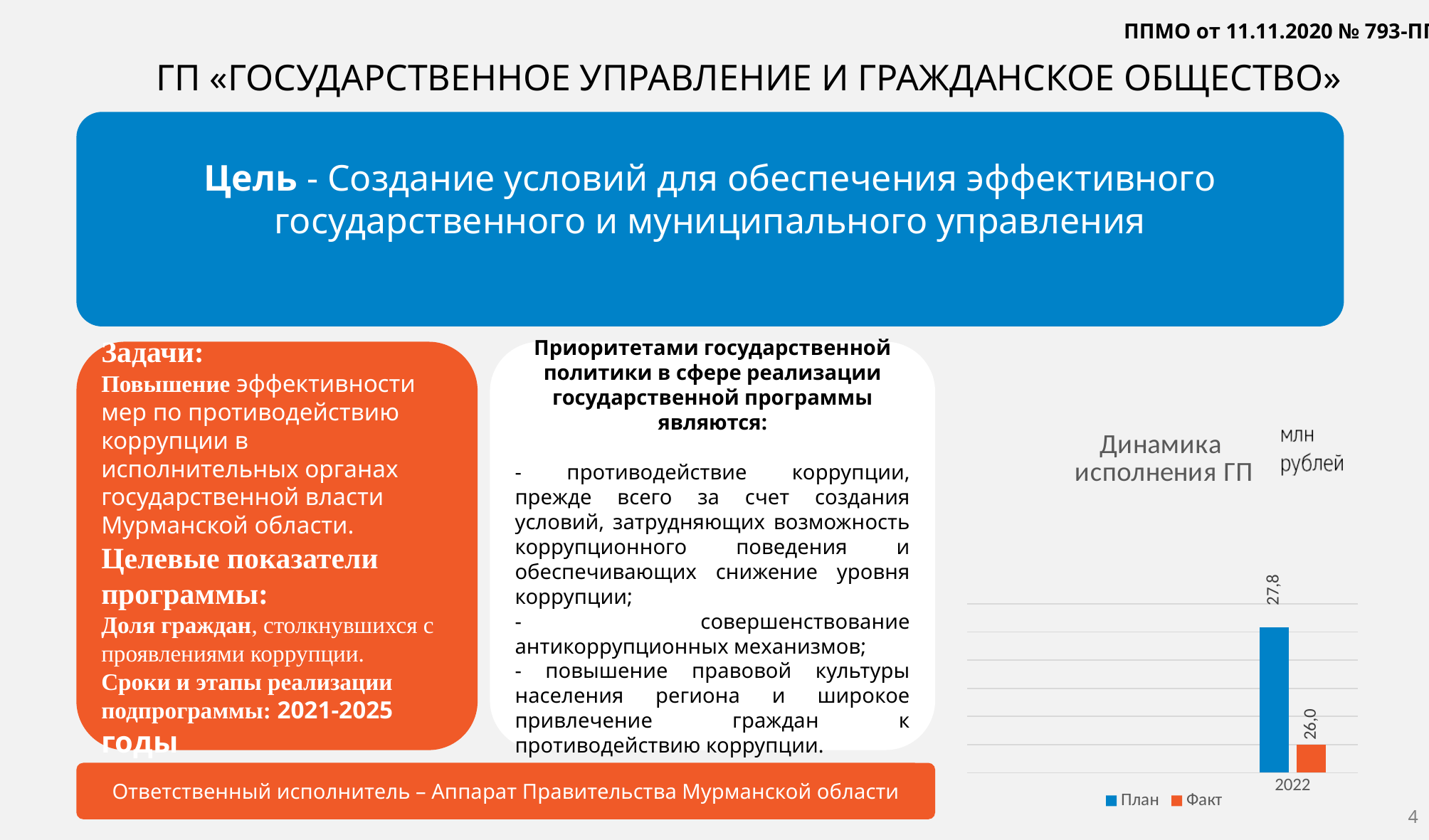
Which year is shown on the x axis of the chart? 2022 What kind of chart is shown on the slide? bar chart Which series has the higher value for 2022, План or Факт? План What is the value of Факт (actual) for 2022 in the chart? 26,0 In what units are the chart values expressed? млн рублей What is the value of План (plan) for 2022 in the chart? 27,8 What is the difference between the План and Факт values for 2022? 1,8 How many categories (years) are shown on the x axis of the chart? 1 Which series has the lowest value in the chart? Факт How many series does the chart legend list? 2 What is the title of the chart on the slide? Динамика исполнения ГП